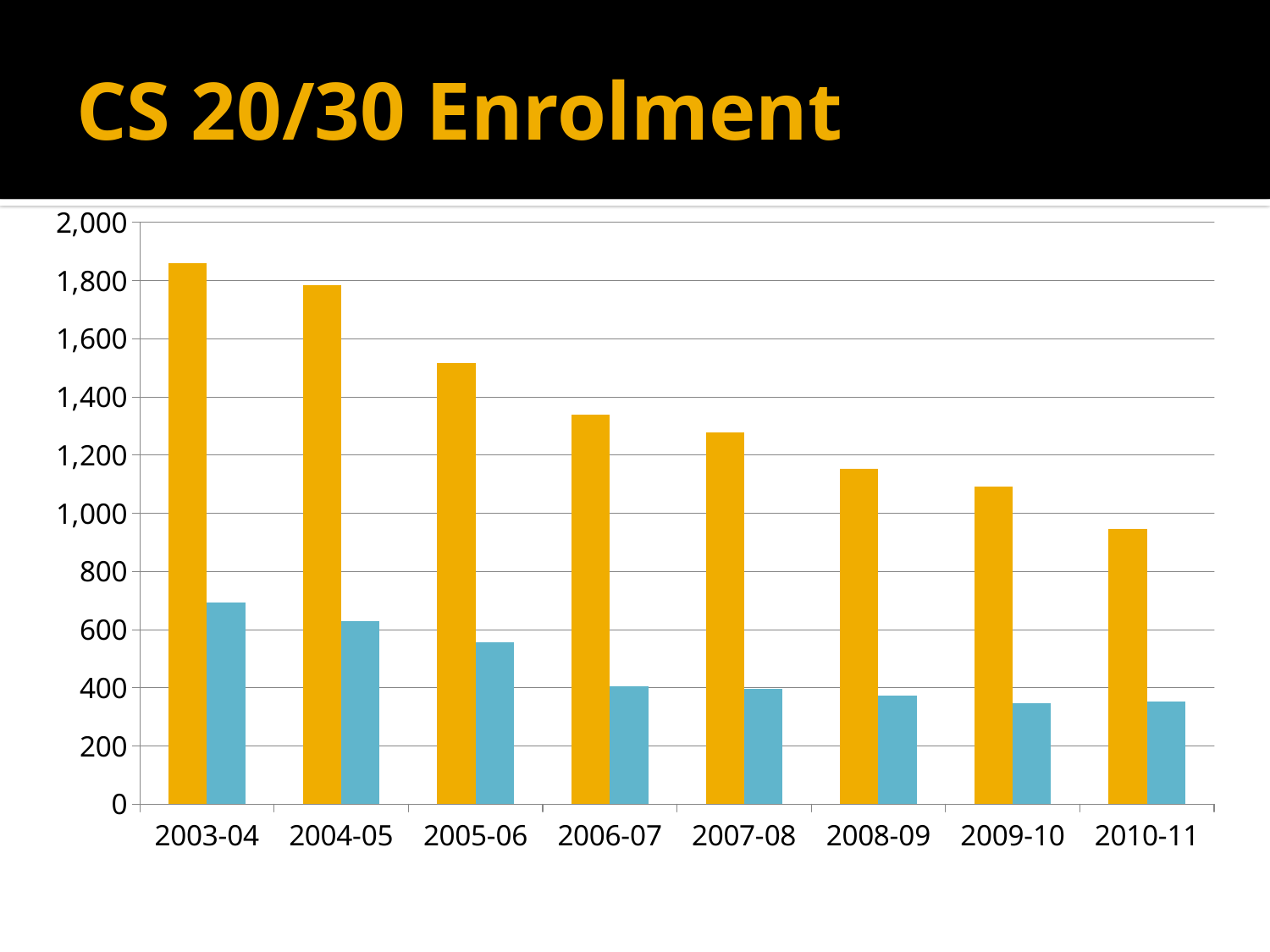
Do the orange bars rise or fall from 2003-04 to 2010-11? fall In which school year is the blue bar the highest? 2003-04 Is the value of the orange bar for 2010-11 greater or less than 1,000? less What kind of chart is shown on the slide? bar chart What is the title of the slide containing the chart? CS 20/30 Enrolment Which is larger, the orange bar for 2005-06 or the orange bar for 2006-07? 2005-06 What two colours are used for the bars in the chart? orange and blue Is the value of the orange bar for 2003-04 greater or less than 1,800? greater How many school years are shown on the x axis of the chart? 8 In which school year is the orange bar the highest? 2003-04 In which school year is the orange bar the lowest? 2010-11 Is the value of the blue bar for 2005-06 greater or less than 400? greater